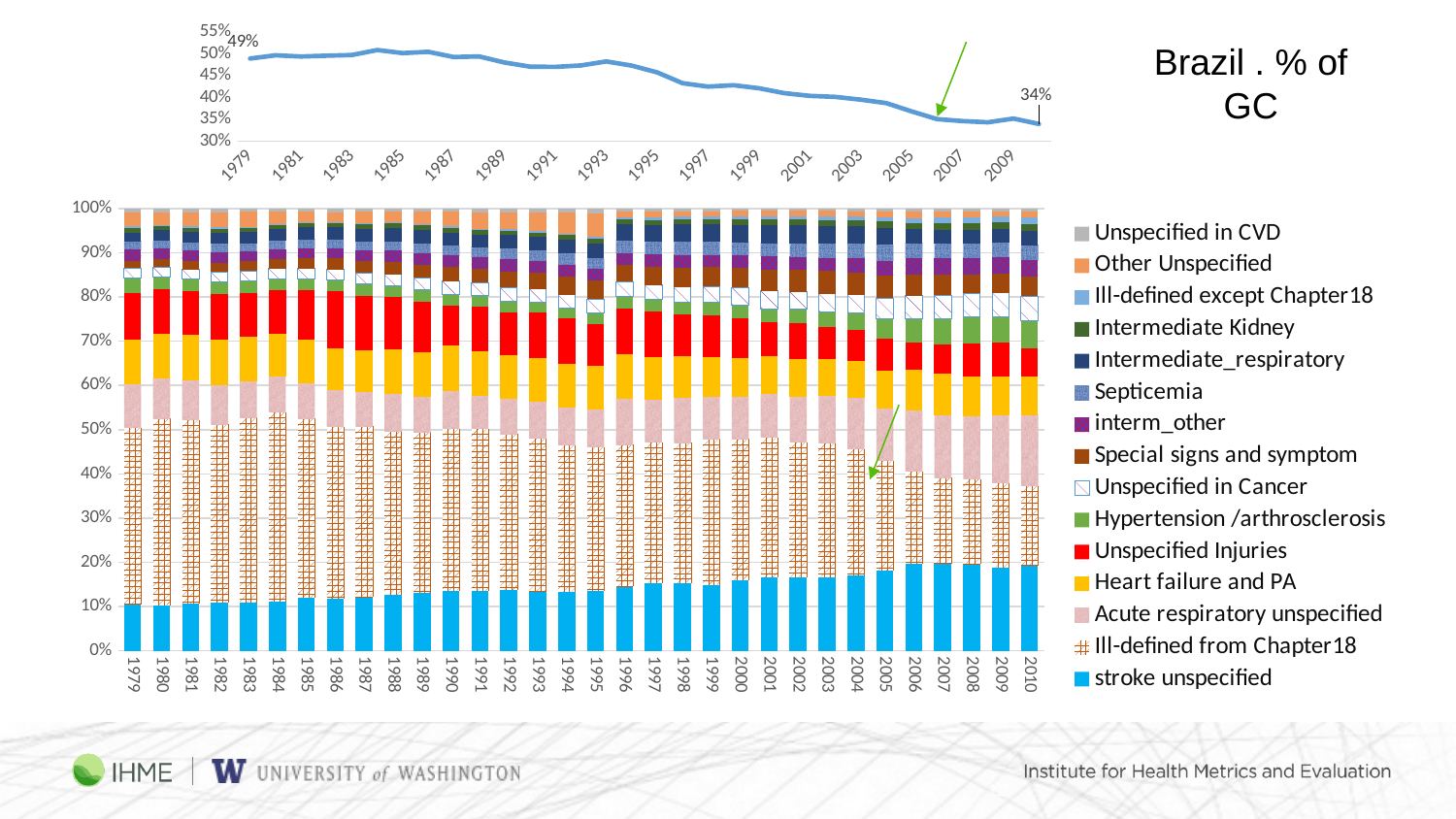
On the top line chart, does the value generally rise or fall from 1979 to 2010? fall On the top line chart titled 'Brazil . % of GC', what value is labeled for 1979? 49% On the bottom stacked bar chart, is the 'stroke unspecified' value for 1979 greater or less than 20%? less On the top line chart, is the value for 1985 greater or less than 45%? greater What kind of chart is the bottom chart with years 1979 to 2010 on the x axis? stacked bar chart On the top line chart, what is the difference between the labeled 1979 value and the labeled 2010 value? 15 percentage points What kind of chart is the top chart titled 'Brazil . % of GC'? line chart How many series does the legend of the bottom stacked bar chart list? 15 On the top line chart titled 'Brazil . % of GC', what value is labeled at the end of the line in 2010? 34% How many years (bars) are shown on the x axis of the bottom stacked bar chart? 32 On the top line chart, is the value for 2007 greater or less than 40%? less On the bottom stacked bar chart, does the 'stroke unspecified' segment rise or fall from 1979 to 2010? rise